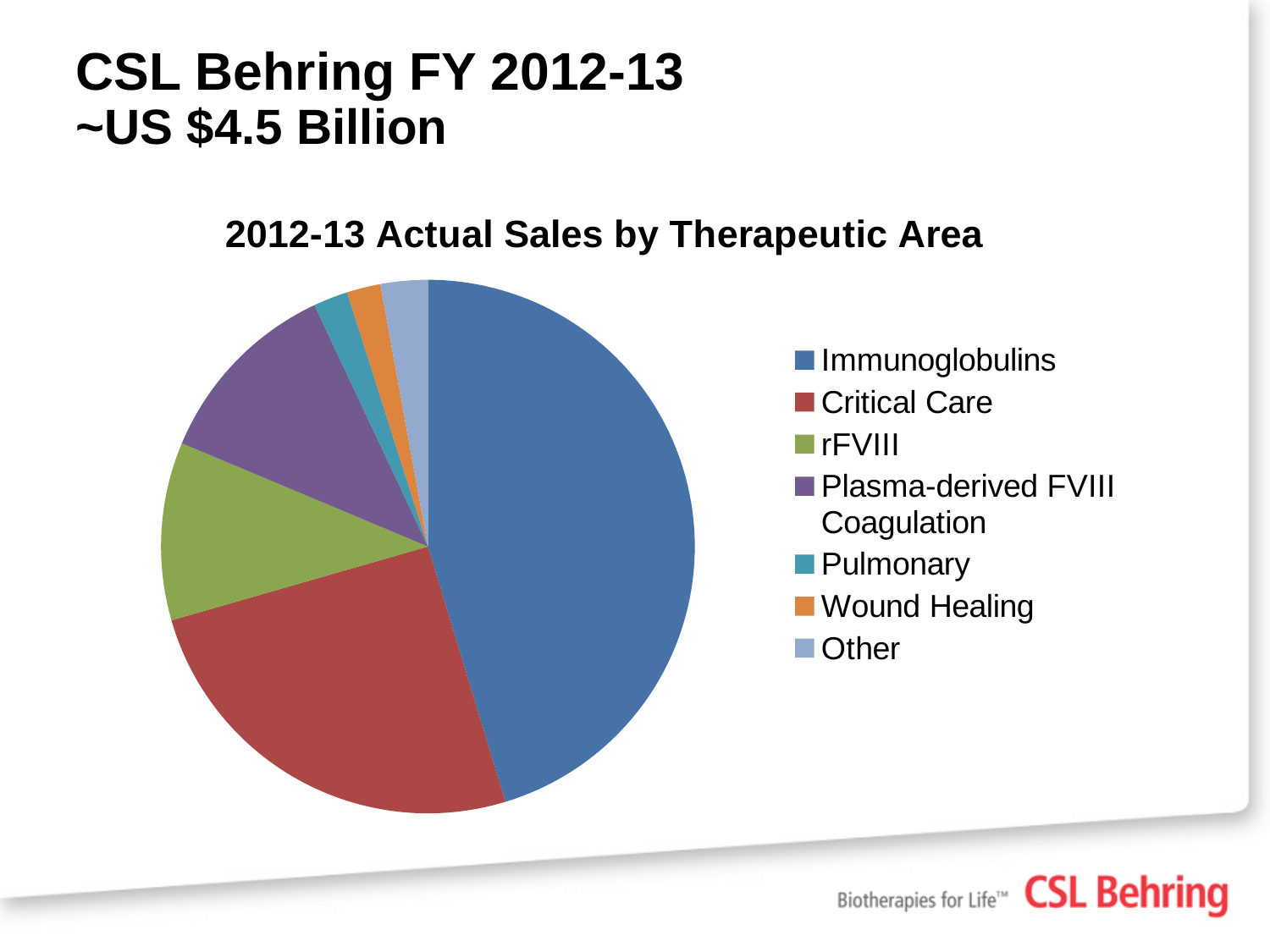
How many entries does the chart legend list? 7 What kind of chart is shown on the slide? pie chart What is the title of the chart? 2012-13 Actual Sales by Therapeutic Area Which therapeutic area has the second-largest slice in the pie chart? Critical Care Which therapeutic area has the largest share of sales in the pie chart? Immunoglobulins Which slice is larger, Critical Care or rFVIII? Critical Care Which slice is larger, Immunoglobulins or Critical Care? Immunoglobulins Which slice is larger, Plasma-derived FVIII Coagulation or Wound Healing? Plasma-derived FVIII Coagulation What colour is the Immunoglobulins slice in the pie chart? blue How many therapeutic areas (slices) does the pie chart show? 7